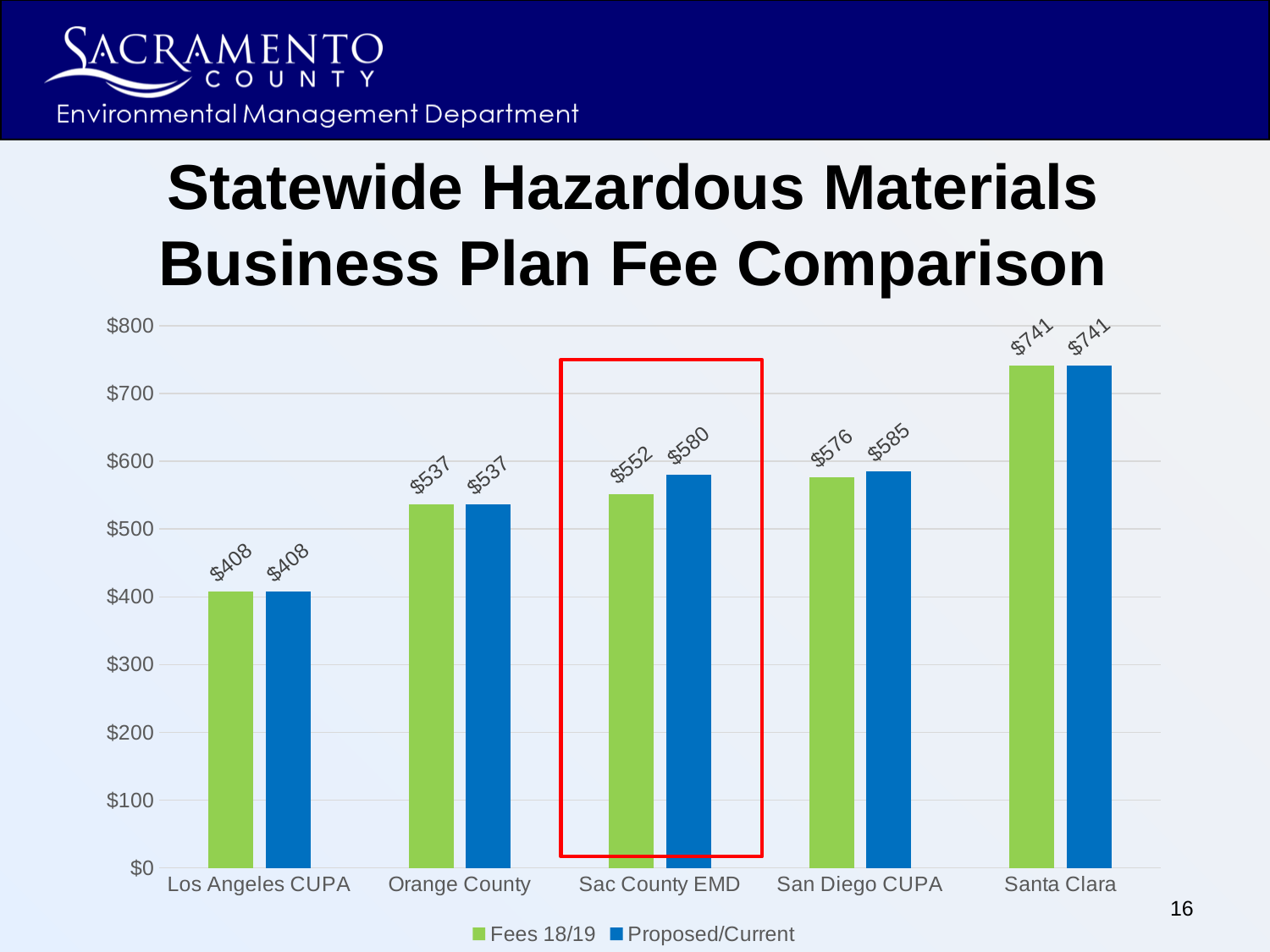
How many categories are shown on the x axis? 5 Which category has the lowest Fees 18/19 value? Los Angeles CUPA Which is larger: the Proposed/Current fee for Sac County EMD or for San Diego CUPA? San Diego CUPA What is the Proposed/Current value for Los Angeles CUPA? $408 What is the Proposed/Current value for San Diego CUPA? $585 How many series does the legend list? 2 Which category is highlighted with a red box on the chart? Sac County EMD What is the difference between the Proposed/Current fee for Santa Clara and for Orange County? $204 Which category has the highest Proposed/Current fee? Santa Clara What is the difference between the Proposed/Current and Fees 18/19 values for Sac County EMD? $28 What is the Fees 18/19 value for Sac County EMD? $552 What kind of chart is shown on the slide? Bar chart